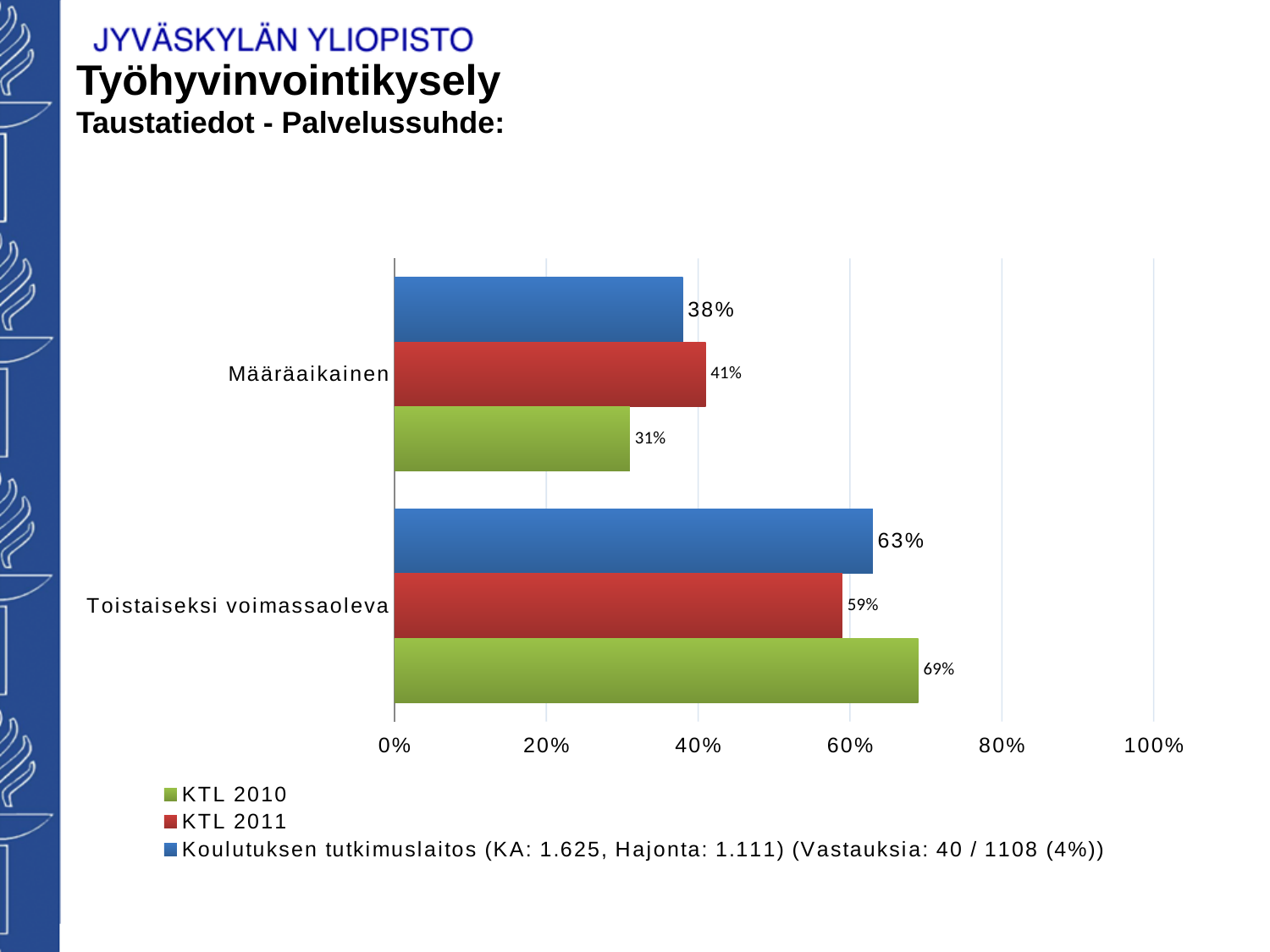
What is the value for KTL 2010 in the Määräaikainen category? 31% Which series has the lowest value in the Määräaikainen category? KTL 2010 What is the difference between the KTL 2010 and KTL 2011 values for Toistaiseksi voimassaoleva? 10% What colour are the KTL 2011 bars? Red What is the value for the Koulutuksen tutkimuslaitos series in the Määräaikainen category? 38% Is the Koulutuksen tutkimuslaitos value for Toistaiseksi voimassaoleva greater or less than 60%? greater How many series does the legend list? 3 Which series has the highest value in the Toistaiseksi voimassaoleva category? KTL 2010 How many categories are shown on the chart? 2 Which is larger for Määräaikainen: the KTL 2011 value or the Koulutuksen tutkimuslaitos value? KTL 2011 What kind of chart is shown on the slide? Bar chart What is the value for KTL 2011 in the Toistaiseksi voimassaoleva category? 59%